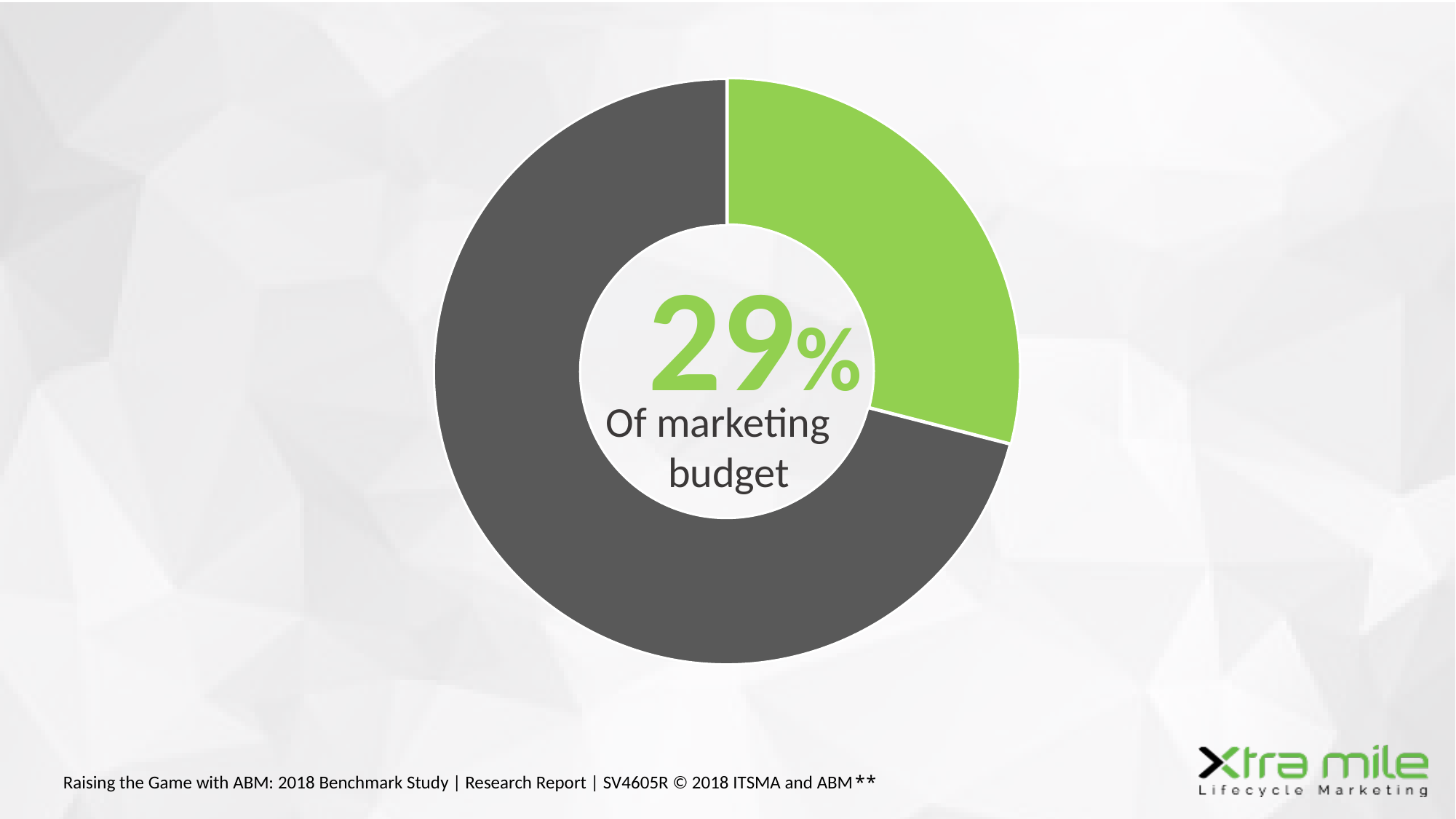
Which slice is larger, the green slice or the grey slice? the grey slice What share of the marketing budget does the green slice represent? 29% What text is printed in the centre of the donut chart? 29% Of marketing budget How many slices does the donut chart have? 2 Is the grey slice's share greater or less than 50%? greater What colour is the slice labelled 29%? green Is the green slice's share greater or less than 50%? less What kind of chart is shown on the slide? donut (pie) chart Which slice of the donut chart is the largest? the grey slice Which slice of the donut chart is the smallest? the green slice